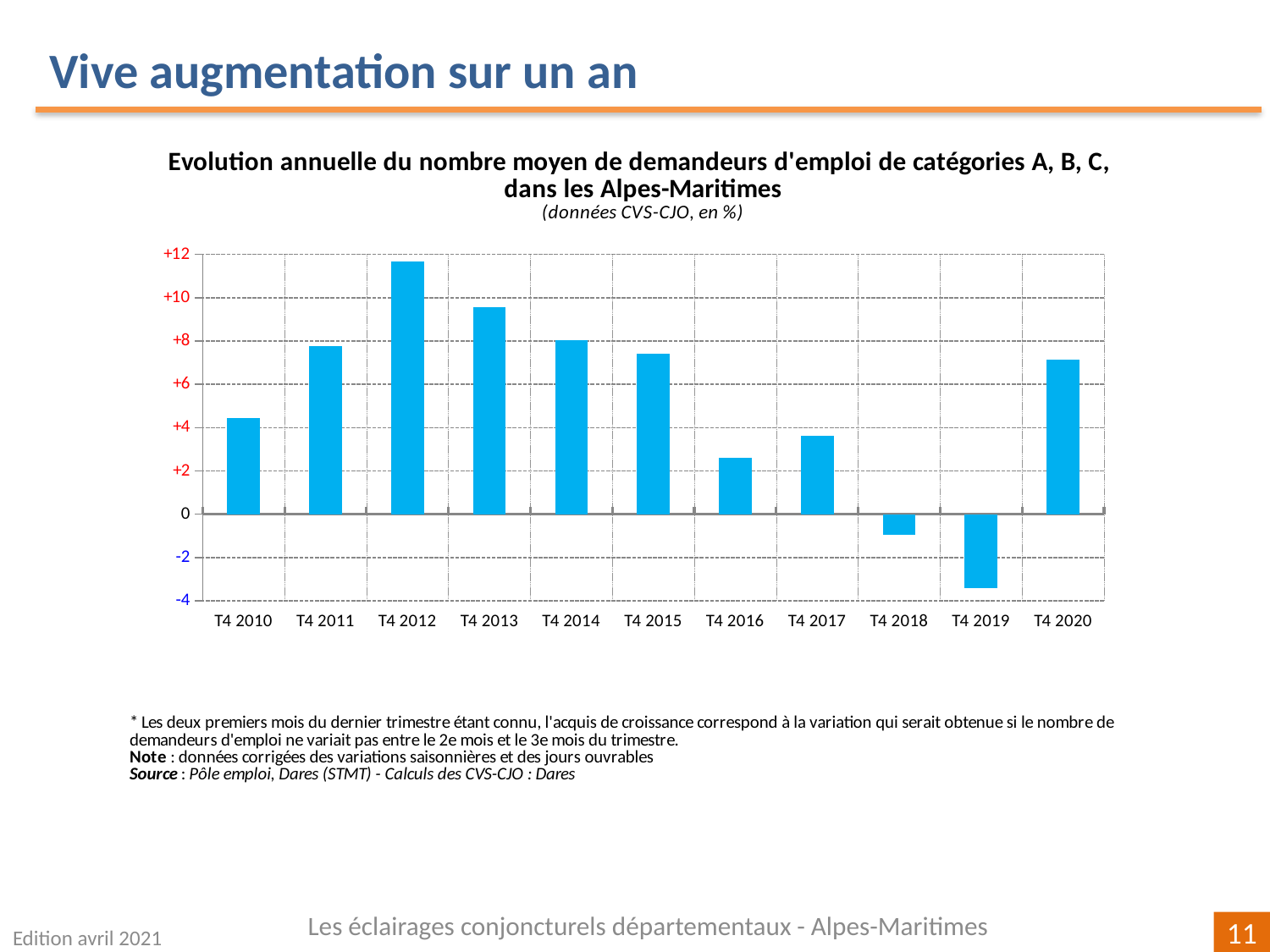
Which quarter has the lowest annual change? T4 2019 Is the value for T4 2019 greater or less than -2? less Is the value for T4 2012 greater or less than +10? greater Is the value for T4 2010 greater or less than +4? greater Which is larger, the value for T4 2016 or the value for T4 2017? T4 2017 In what unit are the data expressed, according to the chart subtitle? en % How many quarters (categories) are plotted on the x axis? 11 What kind of chart is shown on the slide? bar chart How many quarters show a negative value? 2 Which quarter has the highest annual change? T4 2012 Which is larger, the value for T4 2013 or the value for T4 2015? T4 2013